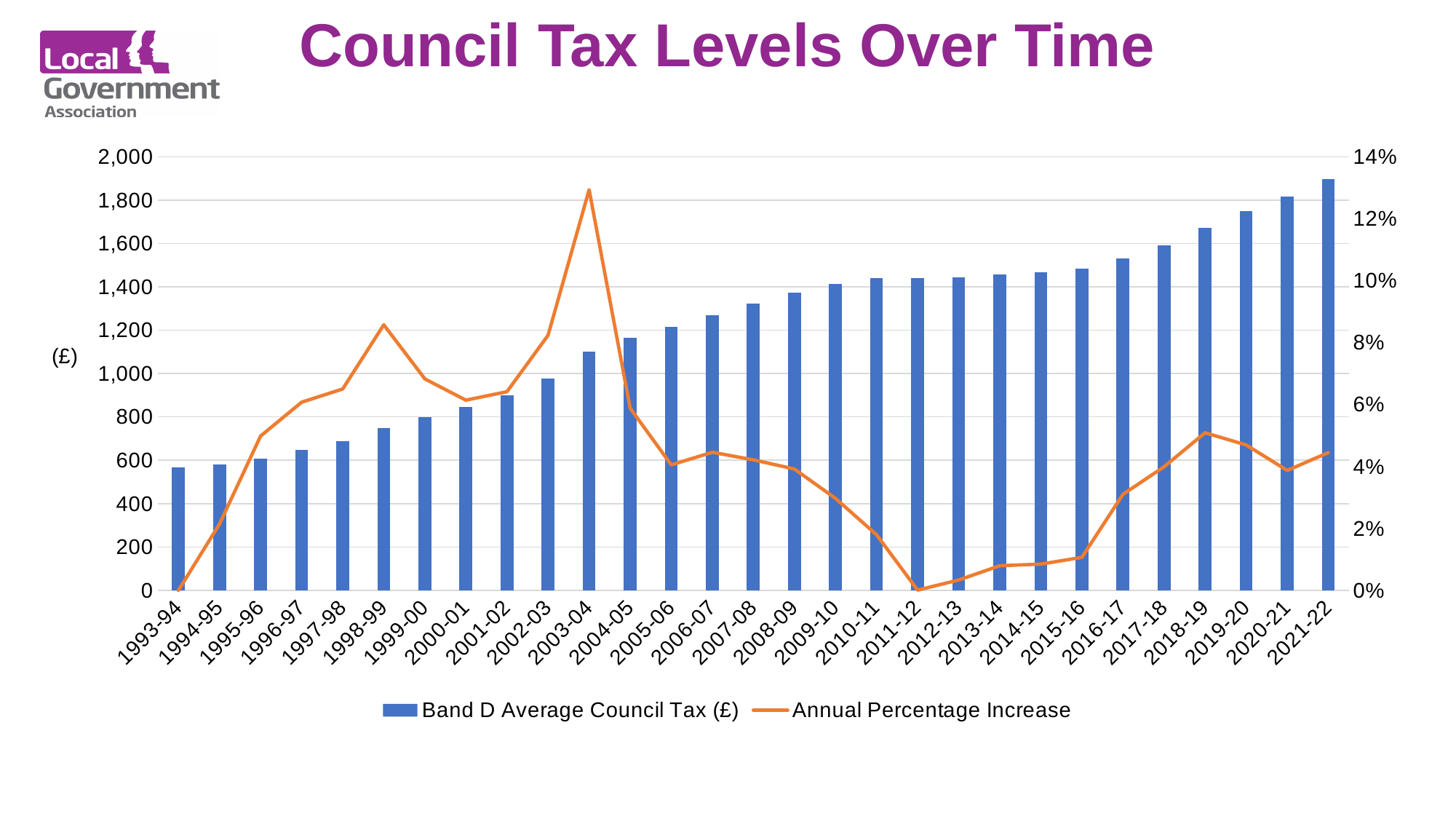
What are the two entries in the chart legend? Band D Average Council Tax (£) and Annual Percentage Increase How many series does the legend list? 2 Is the Annual Percentage Increase for 2011-12 greater or less than 2%? less Is the Annual Percentage Increase for 2003-04 greater or less than 12%? greater How many financial years are shown along the x axis? 29 Is the Band D Average Council Tax for 2021-22 greater or less than 1,800? greater Which year has the lowest Band D Average Council Tax bar? 1993-94 Do the Band D Average Council Tax bars generally rise or fall from 1993-94 to 2021-22? Rise Which year has the larger Annual Percentage Increase, 1998-99 or 2003-04? 2003-04 What kind of chart is shown on the slide? A bar chart combined with a line chart In which year does the Annual Percentage Increase line reach its peak? 2003-04 Which year has the highest Band D Average Council Tax bar? 2021-22